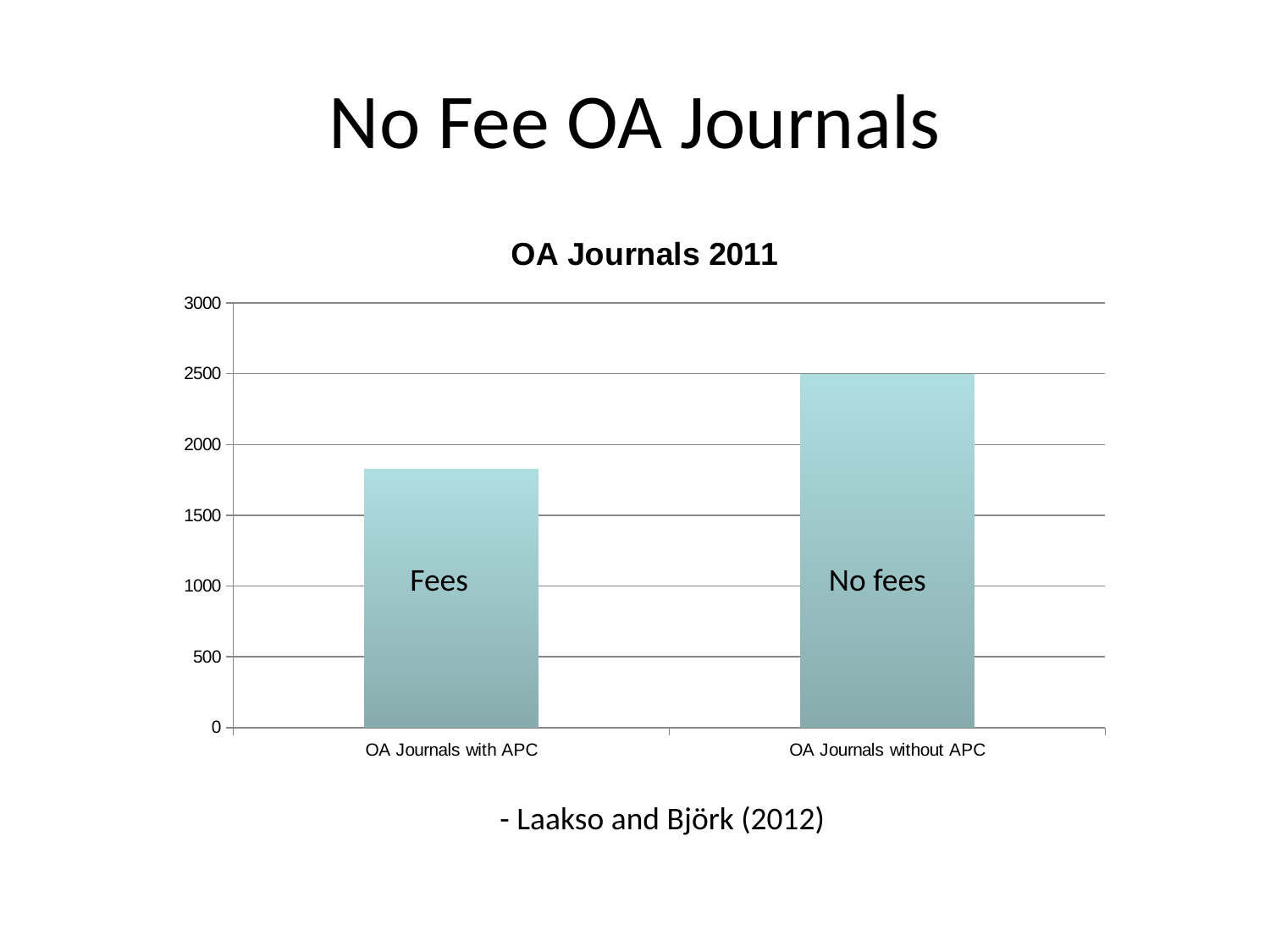
What text label is written inside the bar for OA Journals without APC? No fees Is the value for OA Journals without APC greater or less than 2000? greater Is the value for OA Journals with APC greater or less than 2000? less Which category has the highest value? OA Journals without APC Is the value for OA Journals with APC greater or less than 1500? greater Which category has the lowest value? OA Journals with APC Which is larger, the value for OA Journals with APC or the value for OA Journals without APC? OA Journals without APC What is the title of the chart? OA Journals 2011 Do the values rise or fall from left to right across the categories? rise What kind of chart is shown on the slide? bar chart How many categories are plotted in the chart? 2